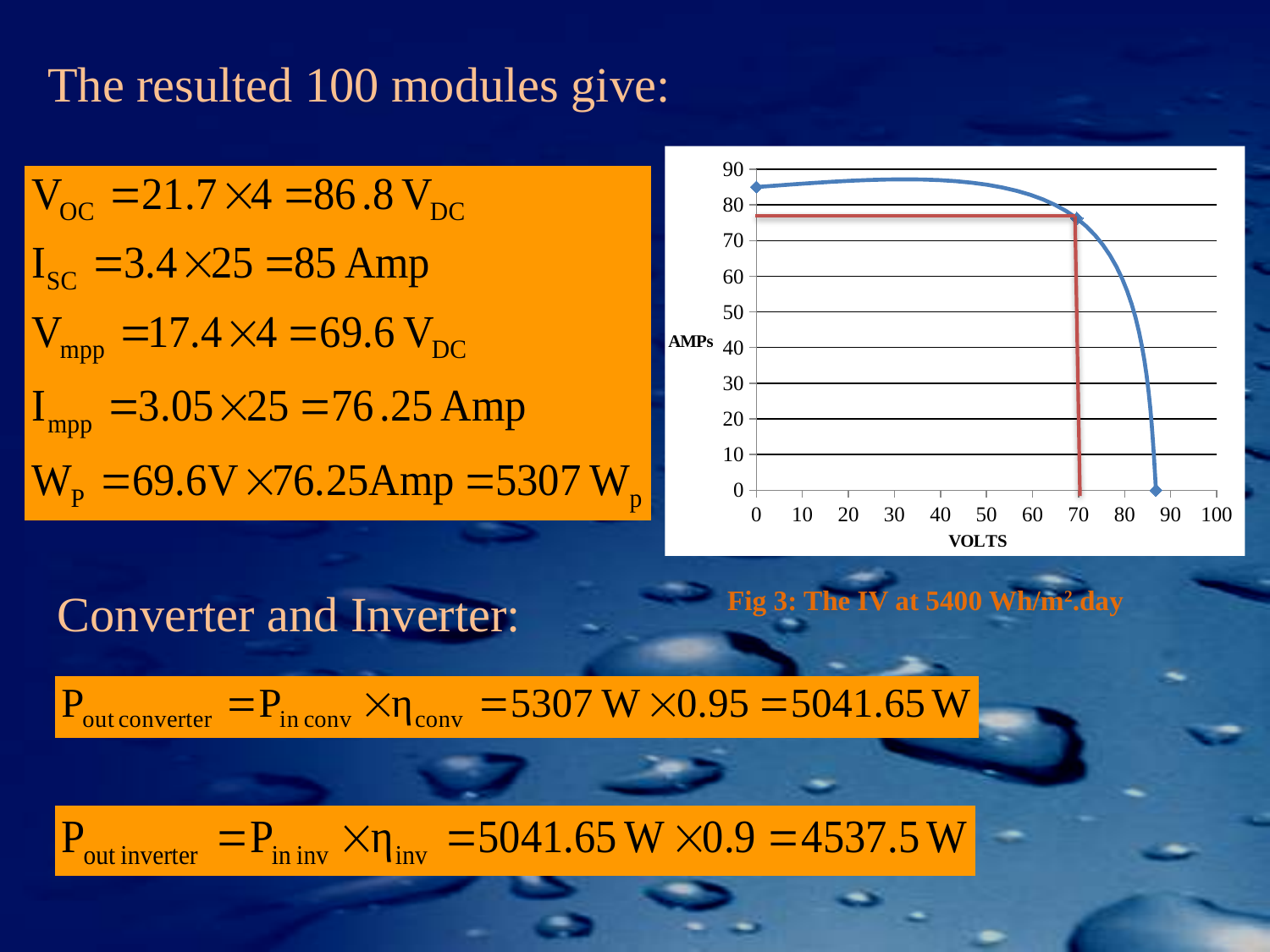
Is the current marked by the red horizontal line greater or less than 70 amps? greater Is the current at 0 volts greater or less than 80 amps? greater What kind of chart is shown on the slide? line chart Is the current at 80 volts greater or less than 80 amps? less What is the caption given for the chart? Fig 3: The IV at 5400 Wh/m².day What is the label of the x axis of the chart? VOLTS Overall, does the current (AMPs) rise or fall as the voltage increases along the x axis? fall